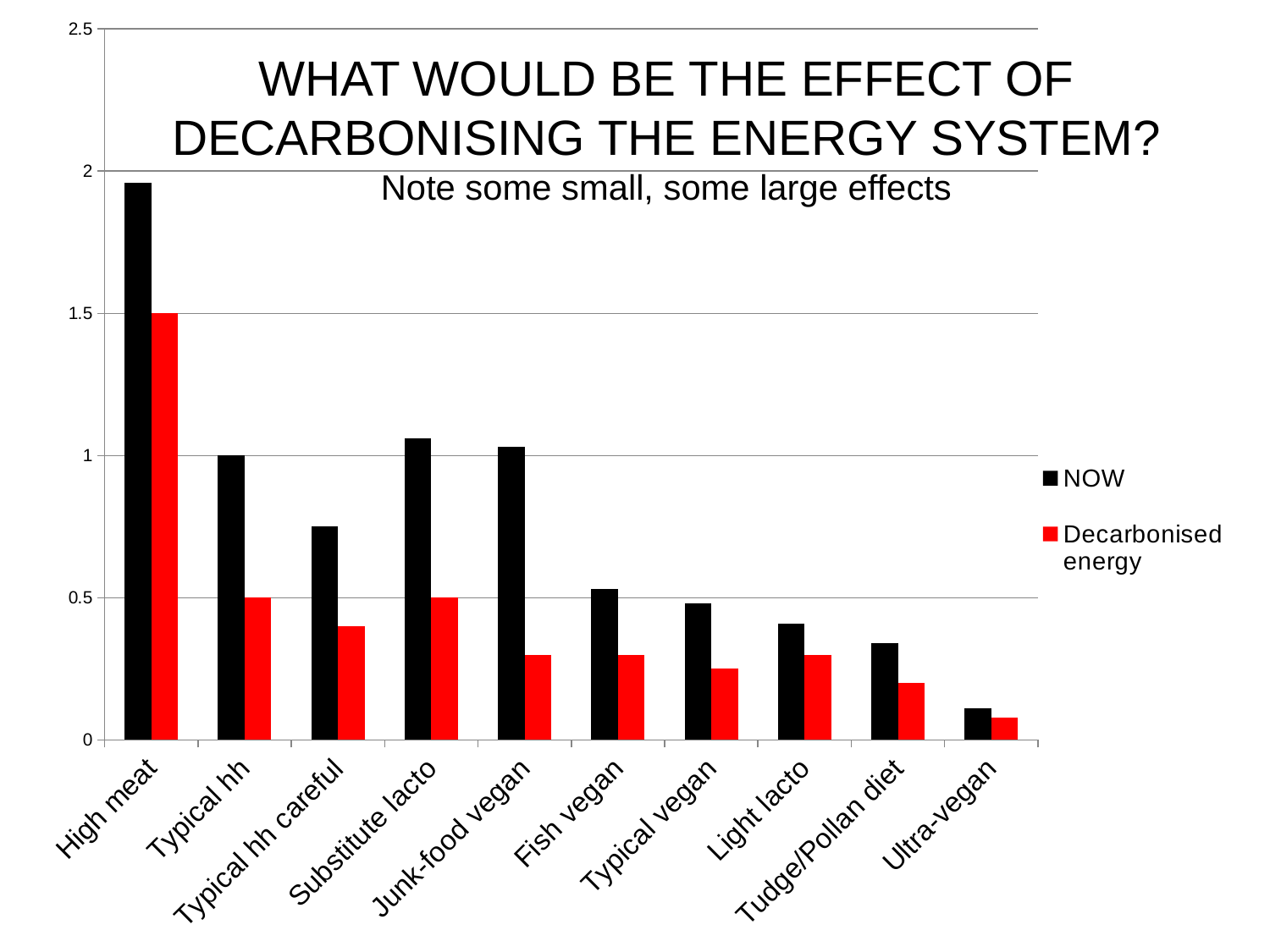
Which category has the lowest NOW value? Ultra-vegan Which category has a larger NOW value, Fish vegan or Light lacto? Fish vegan How many series does the legend list? 2 Is the NOW value for Substitute lacto greater or less than 1? greater What kind of chart is shown on the slide? bar chart Which category has the highest NOW value? High meat Which is larger for Typical hh careful: the NOW value or the Decarbonised energy value? NOW Is the NOW value for High meat greater or less than 1.5? greater What colour are the bars for the Decarbonised energy series? red How many diet categories are shown along the x axis? 10 Do the NOW values generally rise or fall from left to right across the categories? fall Is the Decarbonised energy value for Junk-food vegan greater or less than 0.5? less